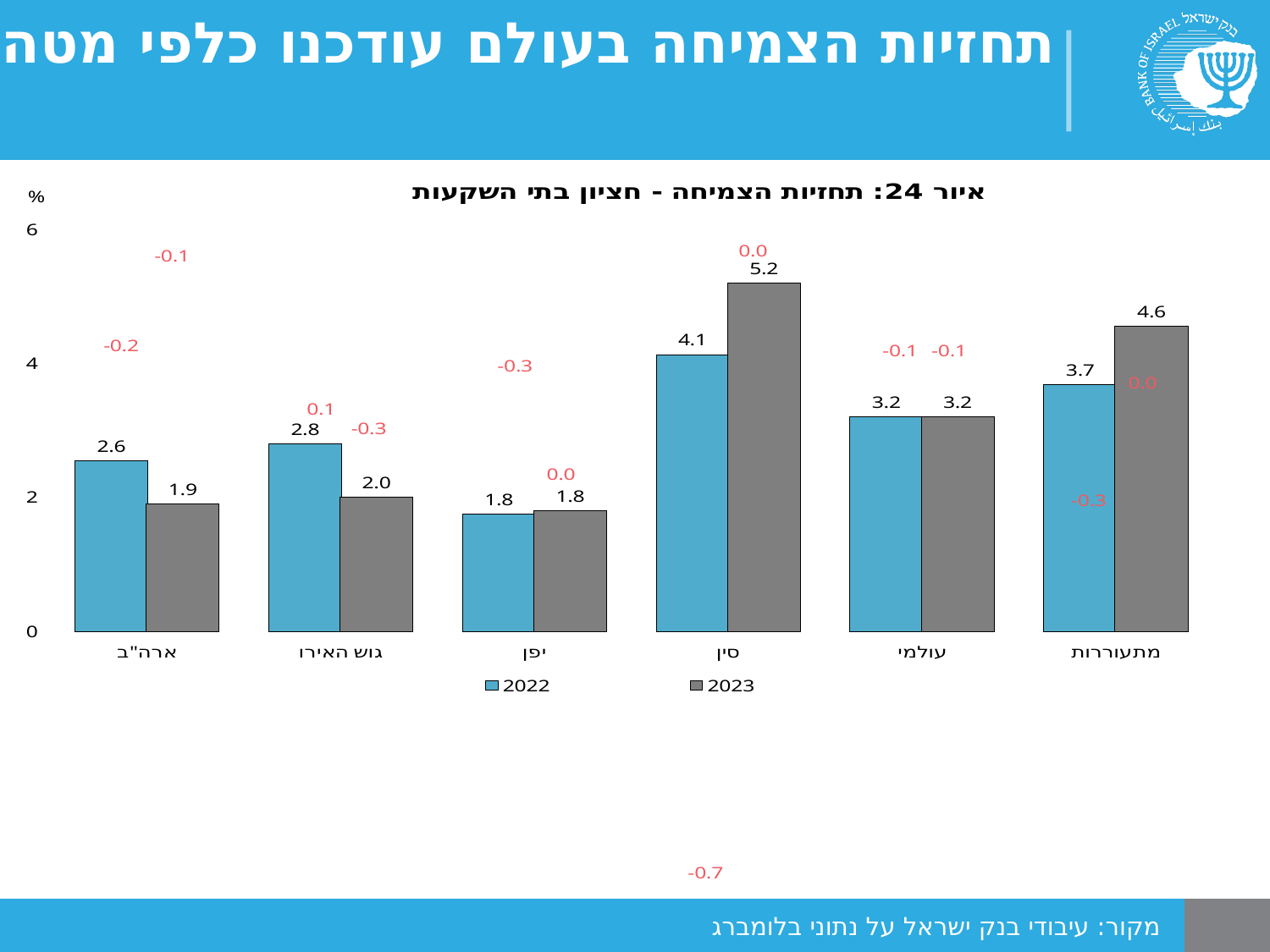
Is the 2023 value for מתעוררות greater or less than 4? greater Which category has the highest 2023 value? סין What are the two series listed in the legend? 2022 and 2023 Which is larger for גוש האירו, the 2022 value or the 2023 value? 2022 What is the difference between the 2023 and 2022 values for סין? 1.1 What is the 2023 value for סין? 5.2 Which category has the lowest 2022 value? יפן What is the 2022 value for ארה"ב? 2.6 What is the 2023 value for מתעוררות? 4.6 What kind of chart is shown on the slide? bar chart How many categories are shown on the x axis? 6 How many series does the legend list? 2